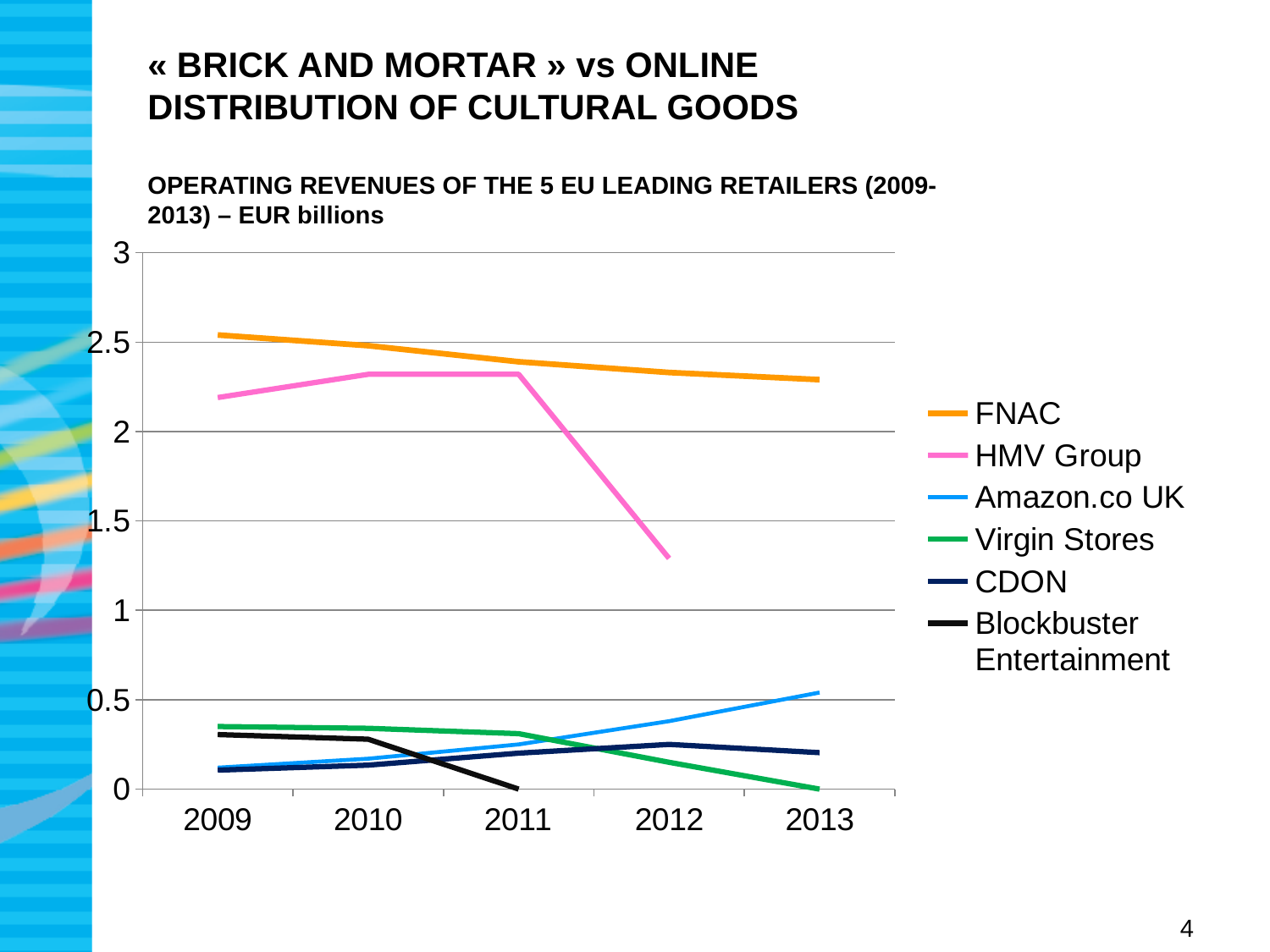
Does the Amazon.co UK line rise or fall from 2009 to 2013? rise Is the value for HMV Group in 2011 greater or less than 2? greater Is the value for HMV Group in 2012 greater or less than 1.5? less How many years are shown on the x axis? 5 Which series has the lowest value in 2013? Virgin Stores In 2013, which is larger: Amazon.co UK or CDON? Amazon.co UK Does the Virgin Stores line rise or fall from 2009 to 2013? fall In 2009, which is larger: FNAC or HMV Group? FNAC How many series does the legend list? 6 What kind of chart is shown on the slide? line chart Does the FNAC line rise or fall from 2009 to 2013? fall Which series has the highest value in 2013? FNAC